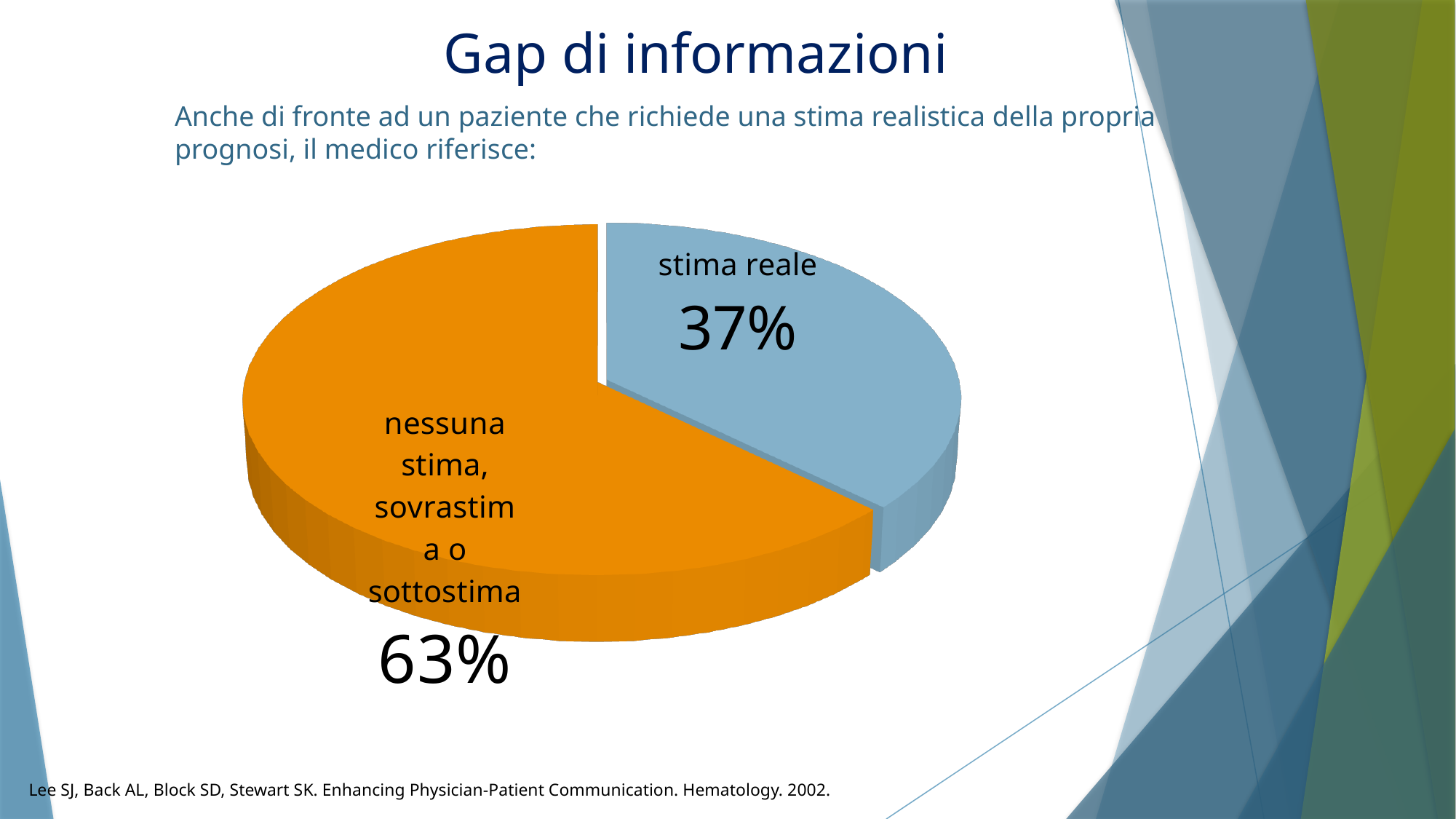
What percentage is shown for the "stima reale" slice? 37% What colour is the "stima reale" slice? light blue What is the difference in percentage points between the "nessuna stima, sovrastima o sottostima" slice and the "stima reale" slice? 26 Which slice of the pie is the largest? nessuna stima, sovrastima o sottostima What is the title of the slide containing the pie chart? Gap di informazioni Which slice of the pie is the smallest? stima reale What share of the pie does the "stima reale" slice represent? 37% What percentage is shown for the "nessuna stima, sovrastima o sottostima" slice? 63% How many slices does the pie chart have? 2 What colour is the "nessuna stima, sovrastima o sottostima" slice? orange What kind of chart is shown on the slide? pie chart Which is larger, the "stima reale" slice or the "nessuna stima, sovrastima o sottostima" slice? nessuna stima, sovrastima o sottostima